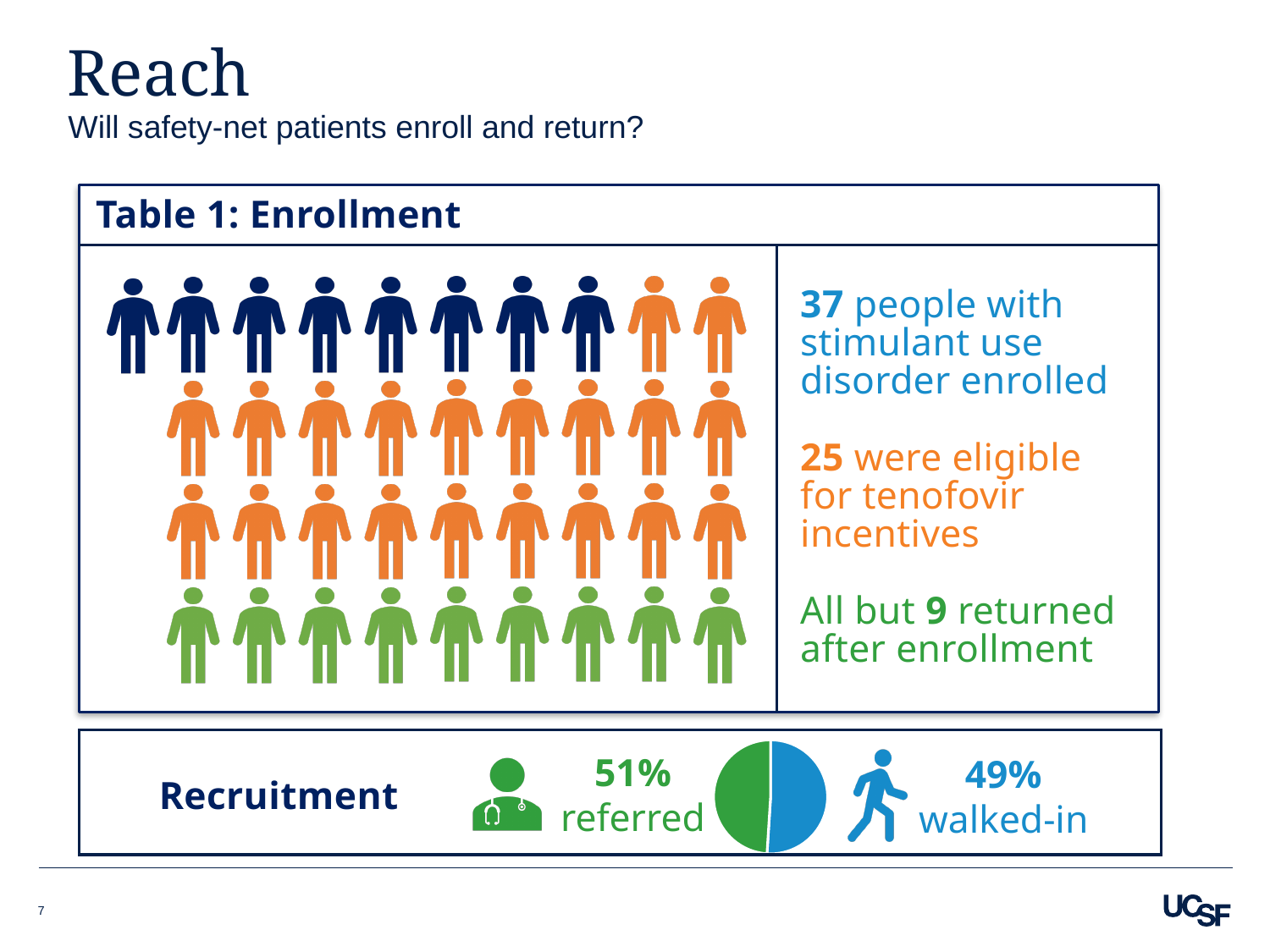
How many slices does the Recruitment pie chart have? 2 In the Recruitment pie chart, what colour is the walked-in slice? blue In the Recruitment pie chart, what share of patients walked in? 49% In the Recruitment pie chart, what colour is the referred slice? green What is the title of the enrollment figure on the slide? Table 1: Enrollment According to Table 1: Enrollment, how many people did not return after enrollment? 9 What kind of chart is shown in the Recruitment section at the bottom of the slide? pie chart In the Recruitment pie chart, which is larger: the referred share or the walked-in share? referred According to Table 1: Enrollment, how many people were eligible for tenofovir incentives? 25 In the Recruitment pie chart, what is the difference between the referred share and the walked-in share? 2% According to Table 1: Enrollment, how many people with stimulant use disorder enrolled? 37 In the Recruitment pie chart, what share of patients were referred? 51%